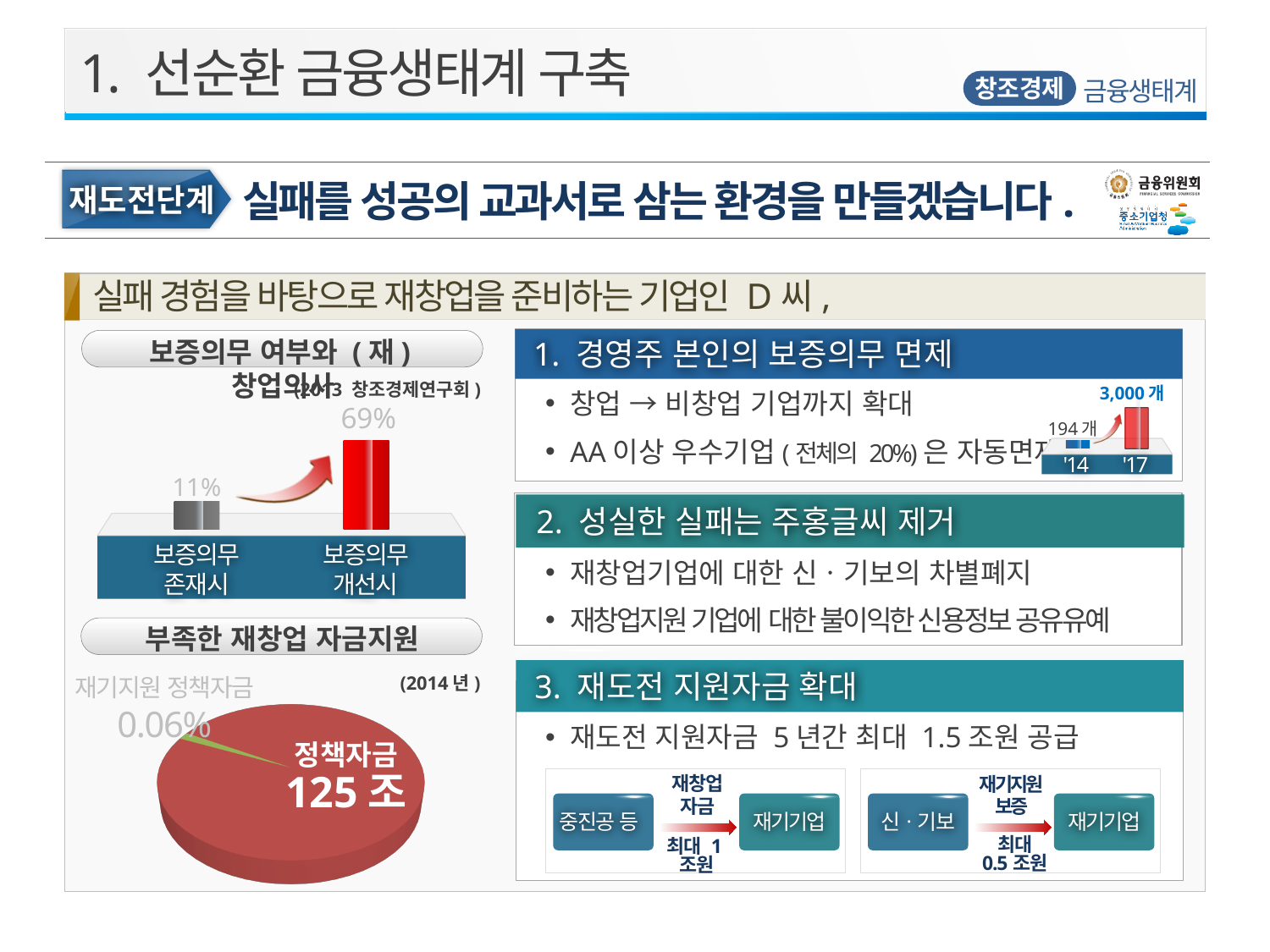
In the small bar chart in the section 경영주 본인의 보증의무 면제, what is the value for '17? 3,000 개 What kind of chart is shown under the heading 보증의무 여부와 (재)창업의사? bar chart In the bar chart titled 보증의무 여부와 (재)창업의사, how many categories are shown? 2 In the small bar chart in the section 경영주 본인의 보증의무 면제, what is the value for '14? 194 개 In the bar chart titled 보증의무 여부와 (재)창업의사, which category has the higher value? 보증의무 개선시 In the bar chart titled 보증의무 여부와 (재)창업의사, what is the value for 보증의무 개선시? 69% What kind of chart is shown under the heading 부족한 재창업 자금지원? pie chart In the bar chart titled 보증의무 여부와 (재)창업의사, what is the value for 보증의무 존재시? 11% In the pie chart under 부족한 재창업 자금지원, what share is shown for 재기지원 정책자금? 0.06% In the pie chart under 부족한 재창업 자금지원, which year is the data from? 2014 년 In the bar chart titled 보증의무 여부와 (재)창업의사, what is the difference between the values for 보증의무 개선시 and 보증의무 존재시? 58% In the pie chart under 부족한 재창업 자금지원, what value is shown for 정책자금? 125 조